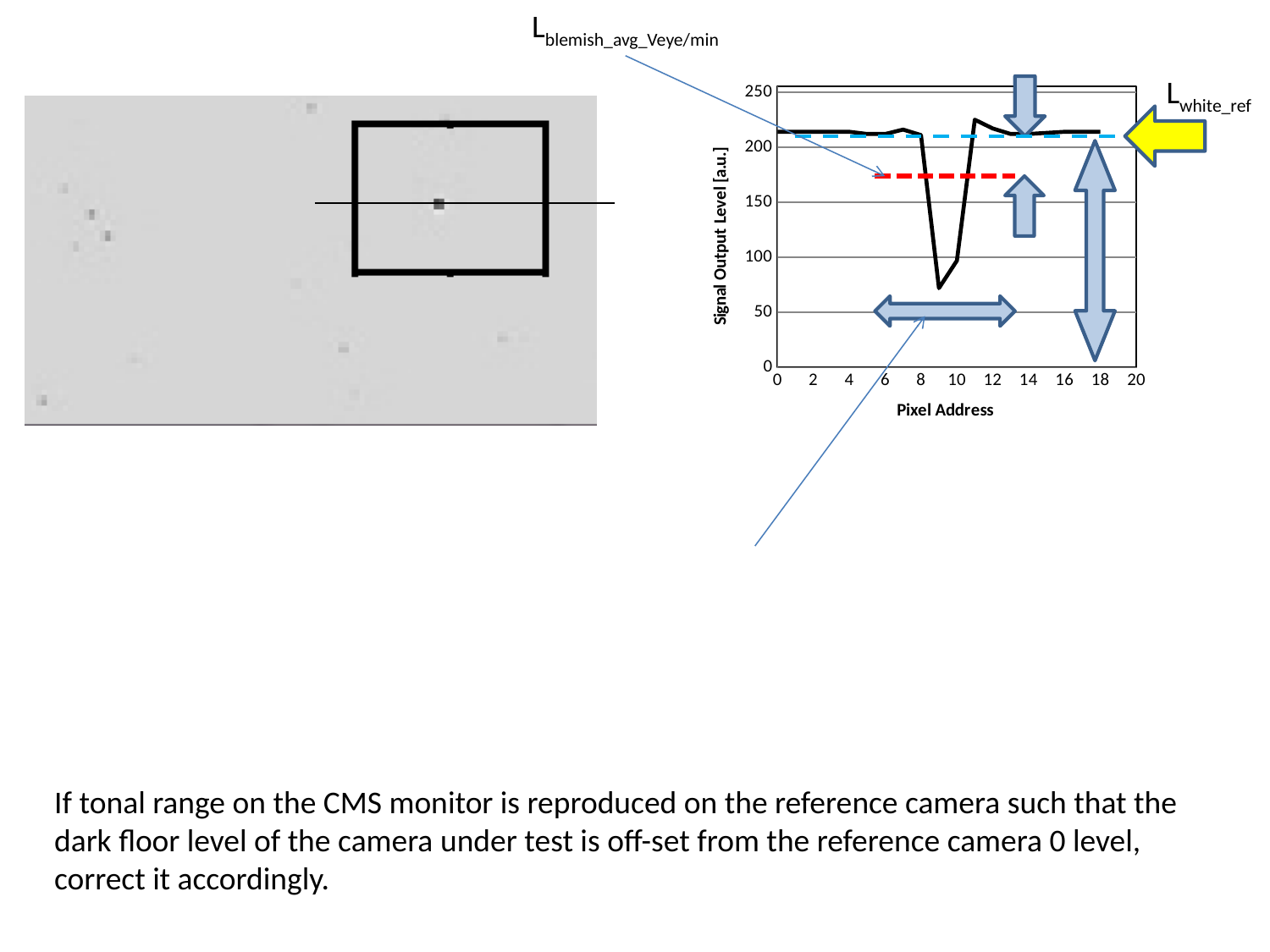
What label is attached to the dashed cyan line near the top of the chart? L white_ref What kind of chart is shown on the slide? line chart Is the signal output level at pixel address 10 greater or less than 150? less What is the title of the x axis of the chart? Pixel Address At which pixel address does the black signal line reach its lowest value? 9 Is the signal output level at pixel address 9 greater or less than 100? less Is the signal output level at pixel address 2 greater or less than 200? greater Between pixel address 9 and pixel address 11, does the signal output level rise or fall? rise Is the signal output level at pixel address 4 larger or smaller than the level at pixel address 9? larger Between pixel address 8 and pixel address 9, does the signal output level rise or fall? fall